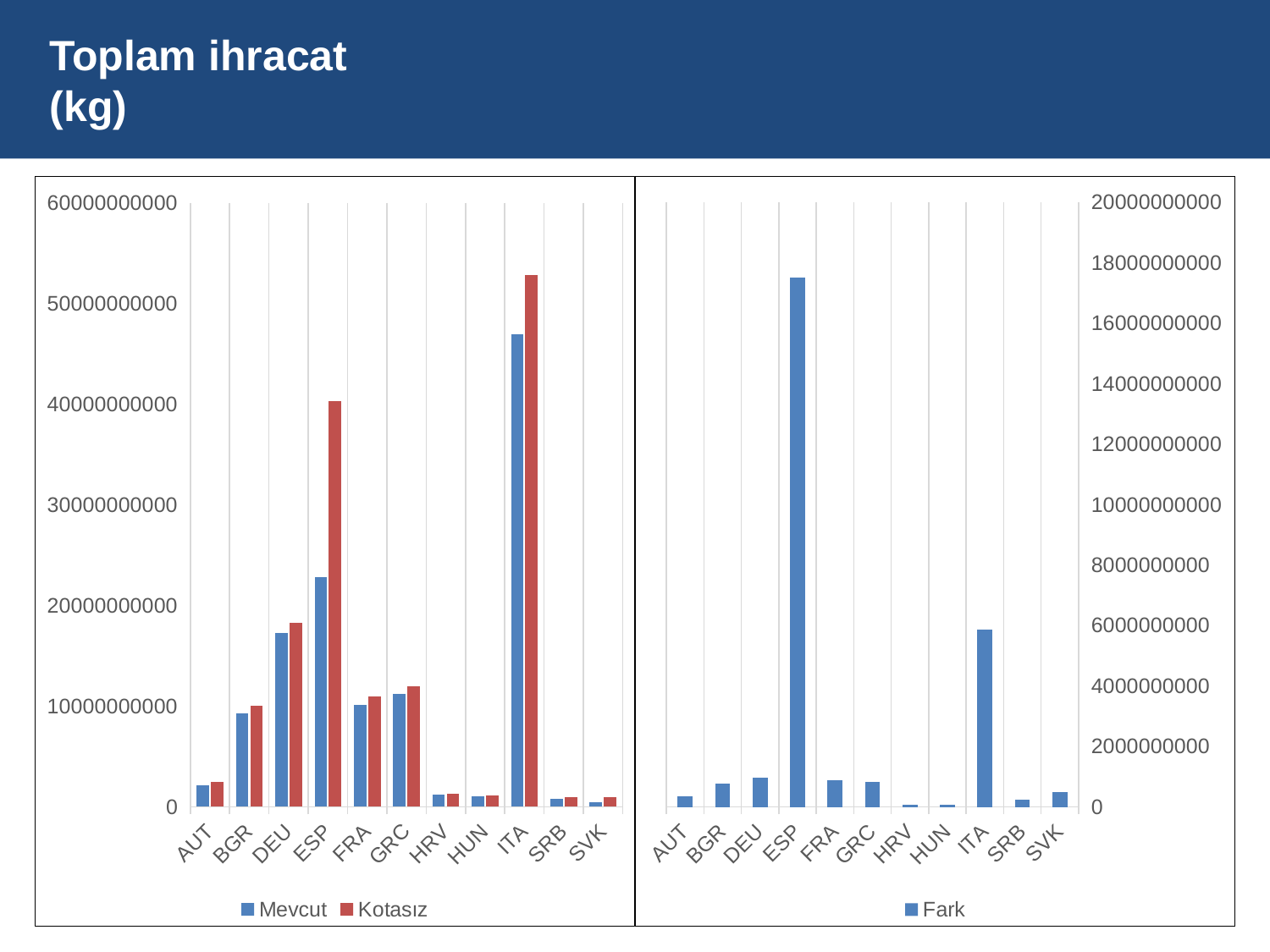
In the right chart, is the Fark value for ITA greater or less than 80000000000? less What is the name of the series shown in the right chart's legend? Fark In the left chart, which is larger for ESP: the Mevcut value or the Kotasız value? Kotasız In the left chart, which category has the highest Kotasız value? ITA In the left chart, which category has the highest Mevcut value? ITA In the right chart, which category has the highest Fark value? ESP In the left chart, is the Mevcut value for ESP greater or less than 300000000000? less In the left chart, is the Kotasız value for ITA greater or less than 500000000000? greater What kind of chart is the left chart on the slide? bar chart How many series does the legend of the left chart list? 2 How many categories are shown on the x axis of the right chart? 11